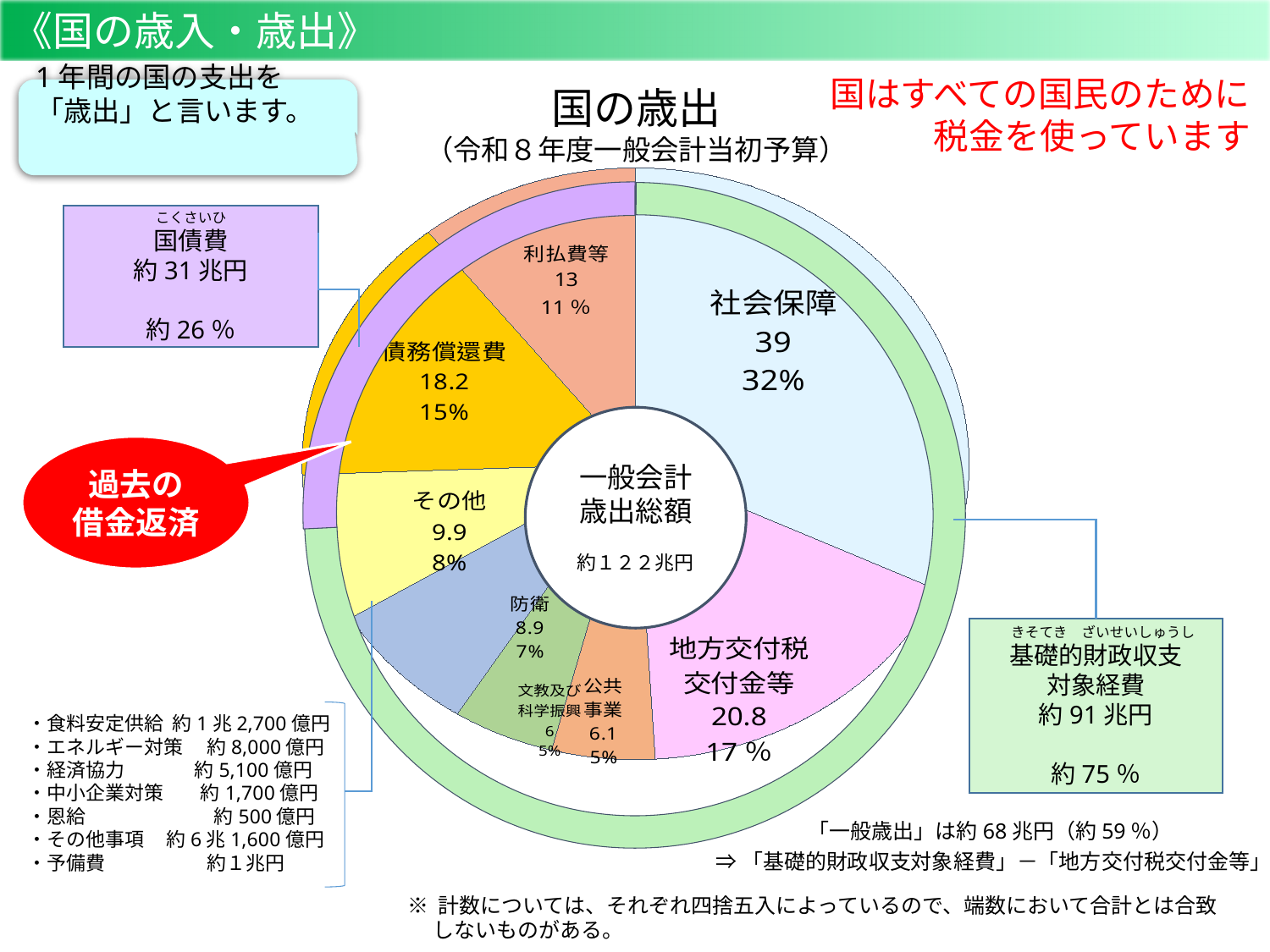
What kind of chart is shown on the slide? pie chart What total amount is shown in the centre of the pie chart for 一般会計歳出総額? 約１２２兆円 What percentage is shown for 利払費等? 11 % What is the difference between the values for 社会保障 and 地方交付税交付金等? 18.2 How many slices does the pie chart have? 8 What is the title of the pie chart? 国の歳出（令和８年度一般会計当初予算） Which category has the smallest slice in the pie chart? 文教及び科学振興 What is the value shown for 債務償還費? 18.2 What is the value shown for 社会保障 in the pie chart? 39 Which category has the largest slice in the pie chart? 社会保障 Which is larger, the value for 防衛 or the value for その他? その他 What percentage share does 地方交付税交付金等 have in the pie chart? 17 %